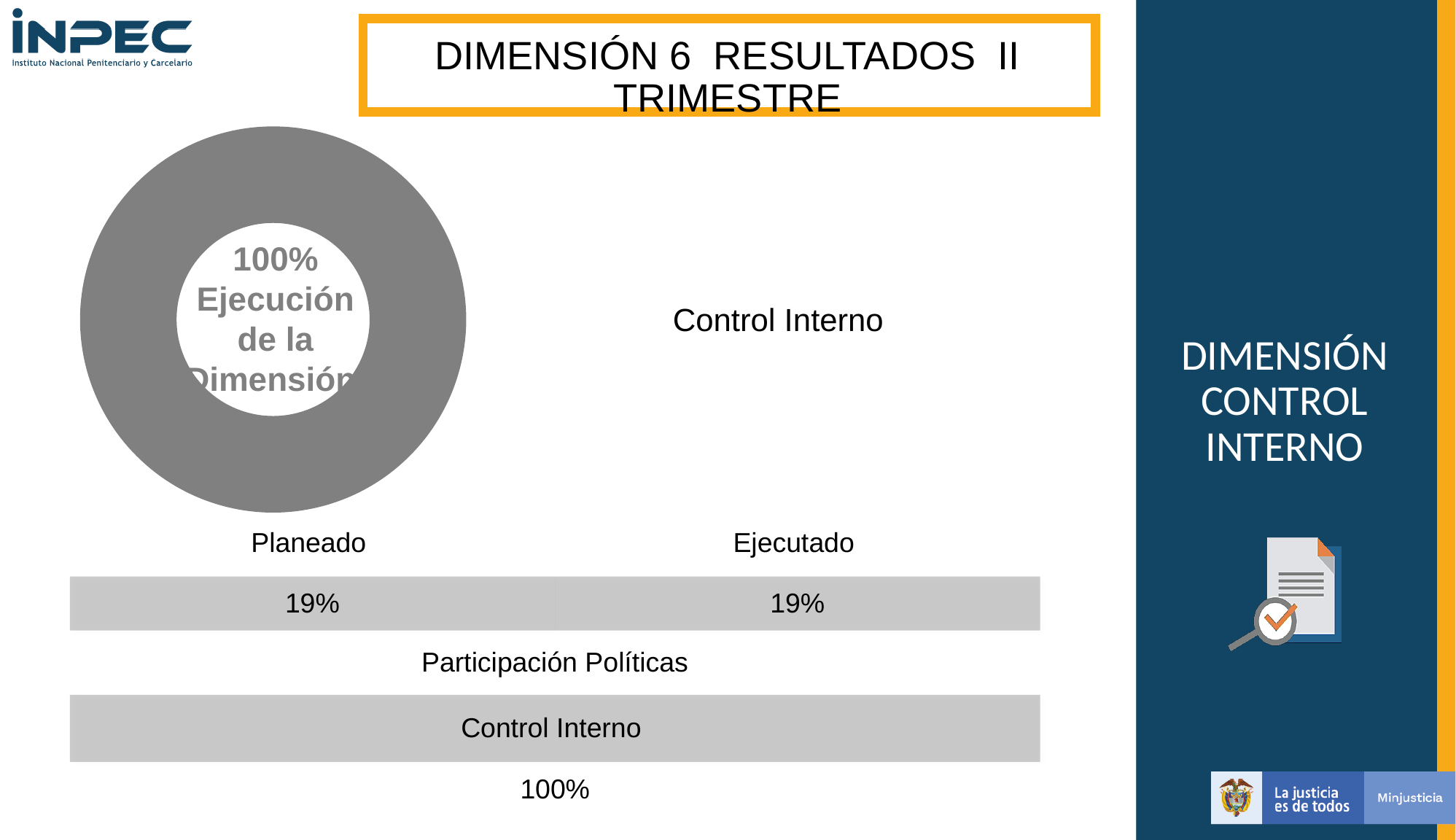
What percentage is printed in the centre of the doughnut chart? 100% What text accompanies the percentage in the centre of the doughnut chart? Ejecución de la Dimensión What kind of chart is shown on the left of the slide? doughnut chart What label appears to the right of the doughnut chart? Control Interno How many slices does the doughnut chart show? 1 What share of the doughnut chart does the single slice occupy? 100% Is the value shown in the doughnut chart greater or less than 50%? greater